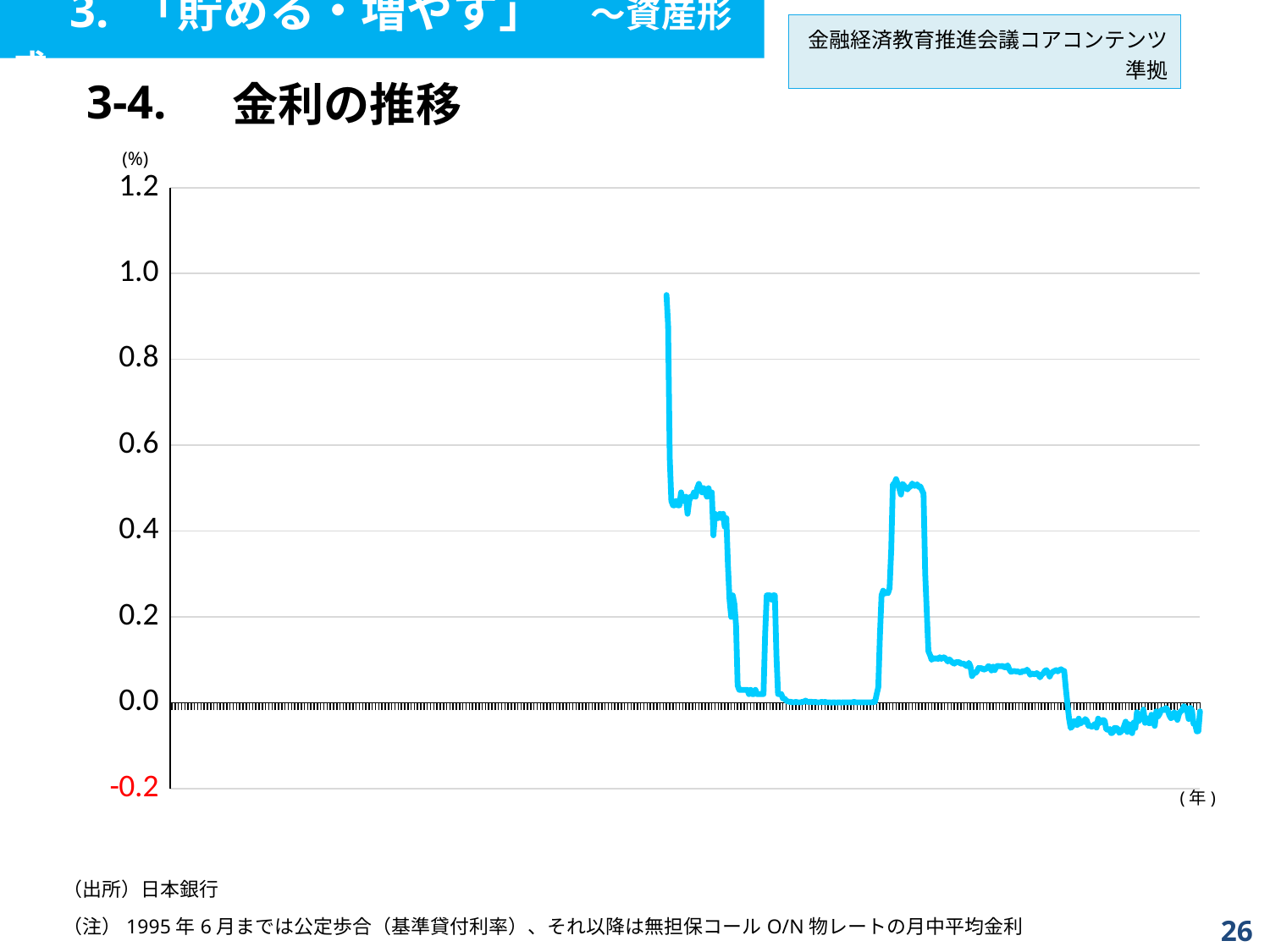
What unit is shown on the vertical axis of the chart? % Overall, does the interest rate line rise or fall from left to right across the chart? fall Is the highest point of the plotted line greater or less than 0.8? greater What is the lowest value labelled on the vertical axis? -0.2 What is the title of the chart on the slide? 3-4. 金利の推移 Is the highest point of the plotted line greater or less than 1.0? less Is the value at the right end of the line greater or less than -0.2? greater What kind of chart is shown on the slide? line chart How many data series are plotted in the chart? 1